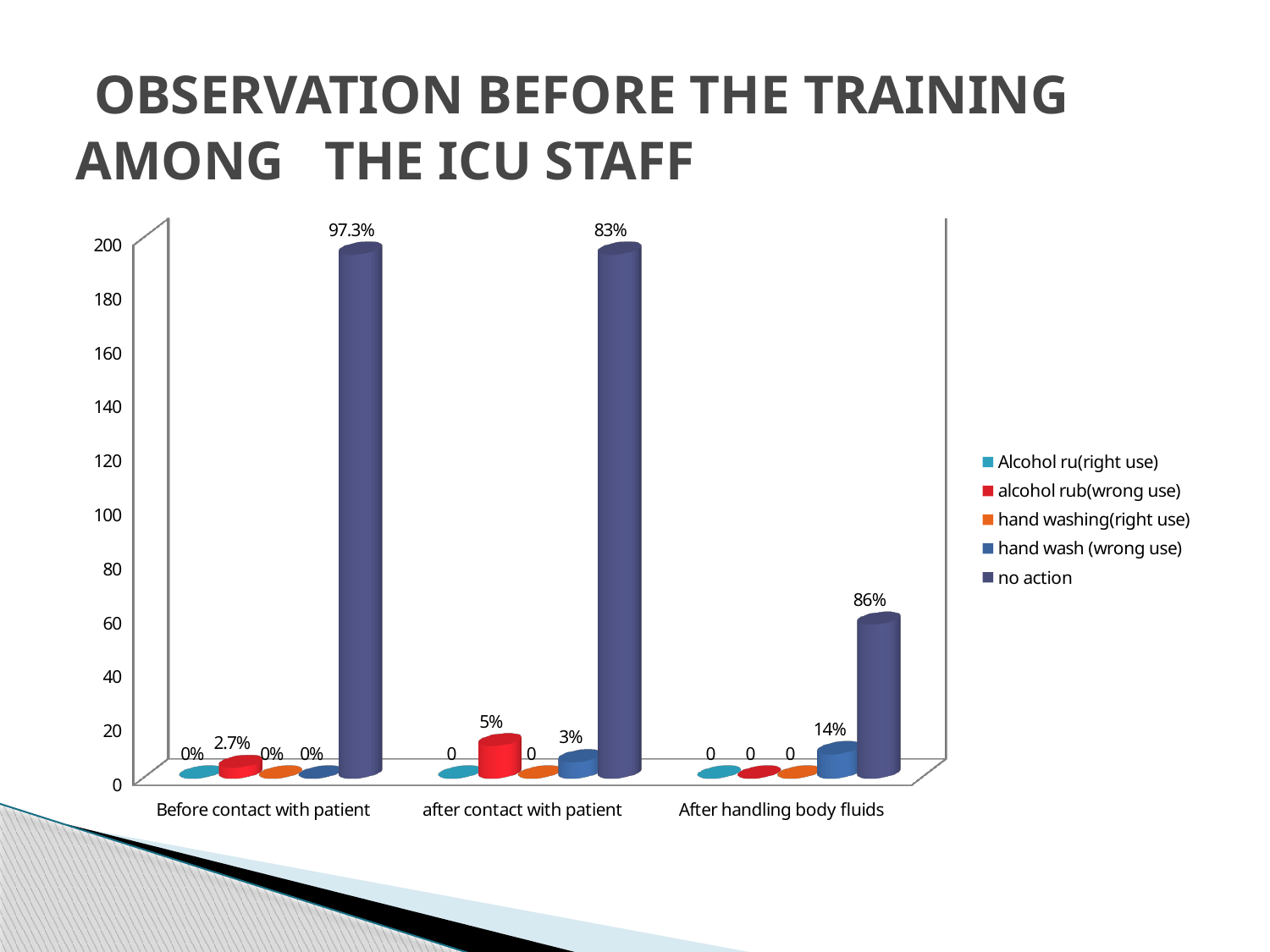
Which is larger: "hand wash (wrong use)" for "After handling body fluids" or "alcohol rub(wrong use)" for "after contact with patient"? hand wash (wrong use) for After handling body fluids How many series does the legend list? 5 In which category is the "no action" value highest? Before contact with patient In the "after contact with patient" category, what is the difference between the "alcohol rub(wrong use)" value and the "hand wash (wrong use)" value? 2% What is the value for "hand wash (wrong use)" in the "After handling body fluids" category? 14% What is the value for "alcohol rub(wrong use)" in the "after contact with patient" category? 5% What is the value for "alcohol rub(wrong use)" in the "Before contact with patient" category? 2.7% What is the value for "hand wash (wrong use)" in the "after contact with patient" category? 3% What is the value for "no action" in the "after contact with patient" category? 83% How many categories are shown on the x axis? 3 What kind of chart is shown on the slide? Bar chart What is the value for "no action" in the "Before contact with patient" category? 97.3%